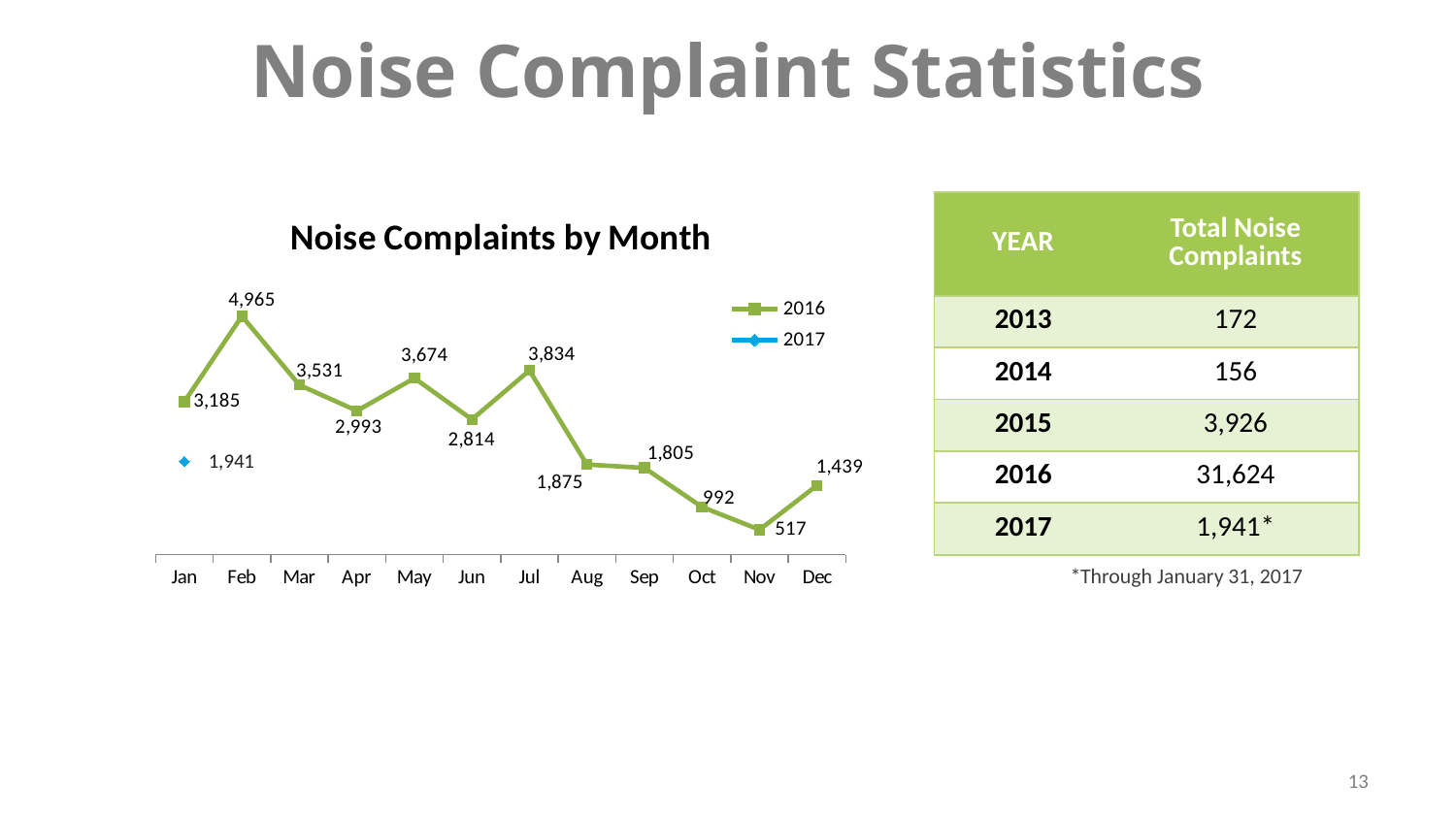
Which is larger in the 2016 series, the value for Jul or the value for May? Jul Do the 2016 values rise or fall from Jul to Nov? fall What kind of chart is shown? line chart What is the title of the chart? Noise Complaints by Month How many months are shown on the x axis? 12 Which month has the highest value in the 2016 series? Feb How many series does the legend list? 2 What is the value for Nov in the 2016 series? 517 What is the value for Feb in the 2016 series? 4,965 Which month has the lowest value in the 2016 series? Nov What is the value for Jan in the 2017 series? 1,941 What is the difference between the 2016 values for Feb and Mar? 1,434